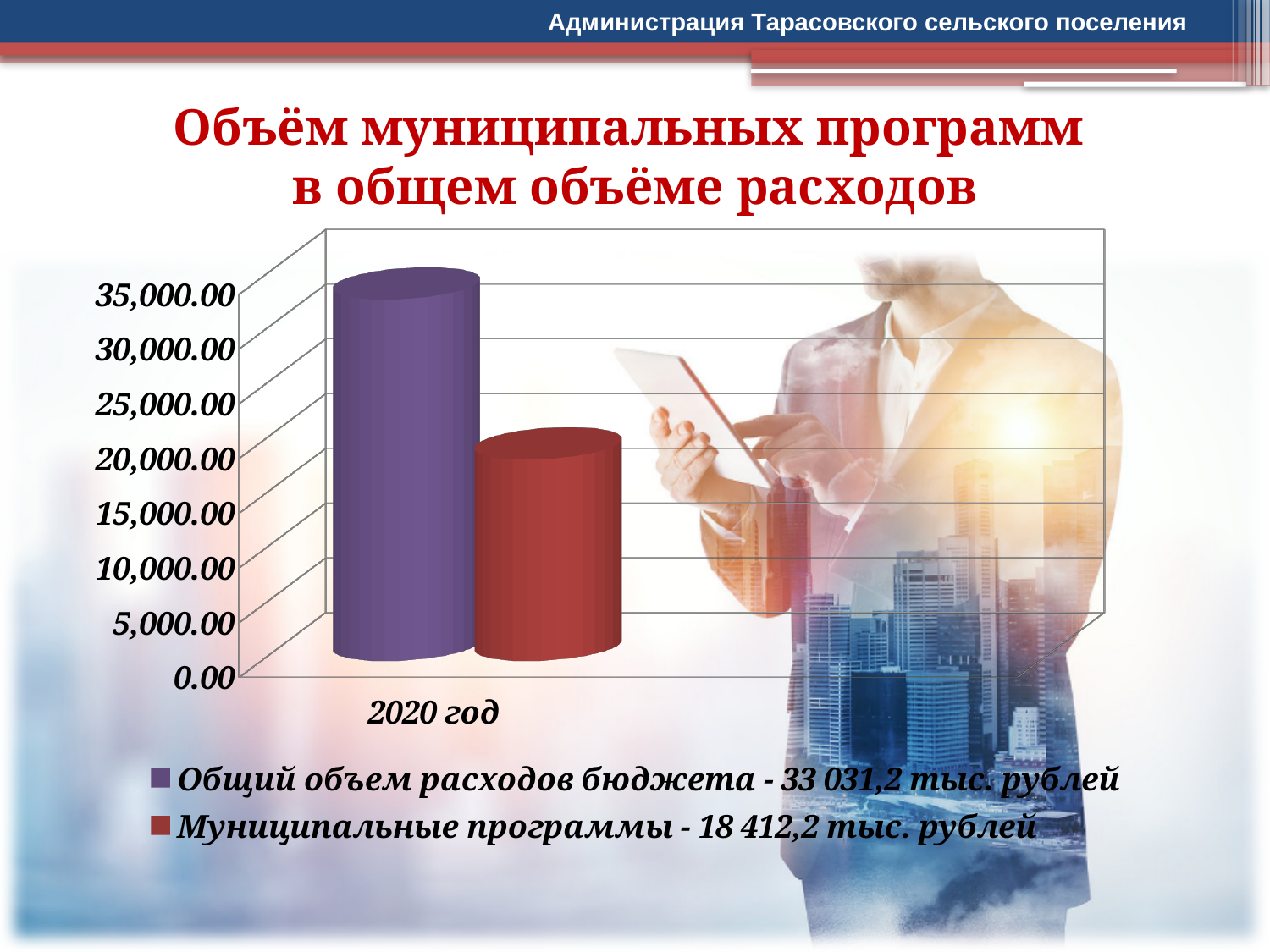
What colour is the bar for Общий объем расходов бюджета? Purple According to the legend, what is the value of Общий объем расходов бюджета? 33 031,2 тыс. рублей How many series does the legend list? 2 What type of chart is shown on the slide? Bar chart Which series has the higher value in 2020? Общий объем расходов бюджета Is the value for Муниципальные программы greater or less than 20,000.00? less Which year is shown on the x axis of the chart? 2020 год What is the title of the chart on the slide? Объём муниципальных программ в общем объёме расходов How many categories are shown on the x axis? 1 Which series has the lower value in 2020? Муниципальные программы What is the difference between Общий объем расходов бюджета and Муниципальные программы? 14 619,0 тыс. рублей According to the legend, what is the value of Муниципальные программы? 18 412,2 тыс. рублей